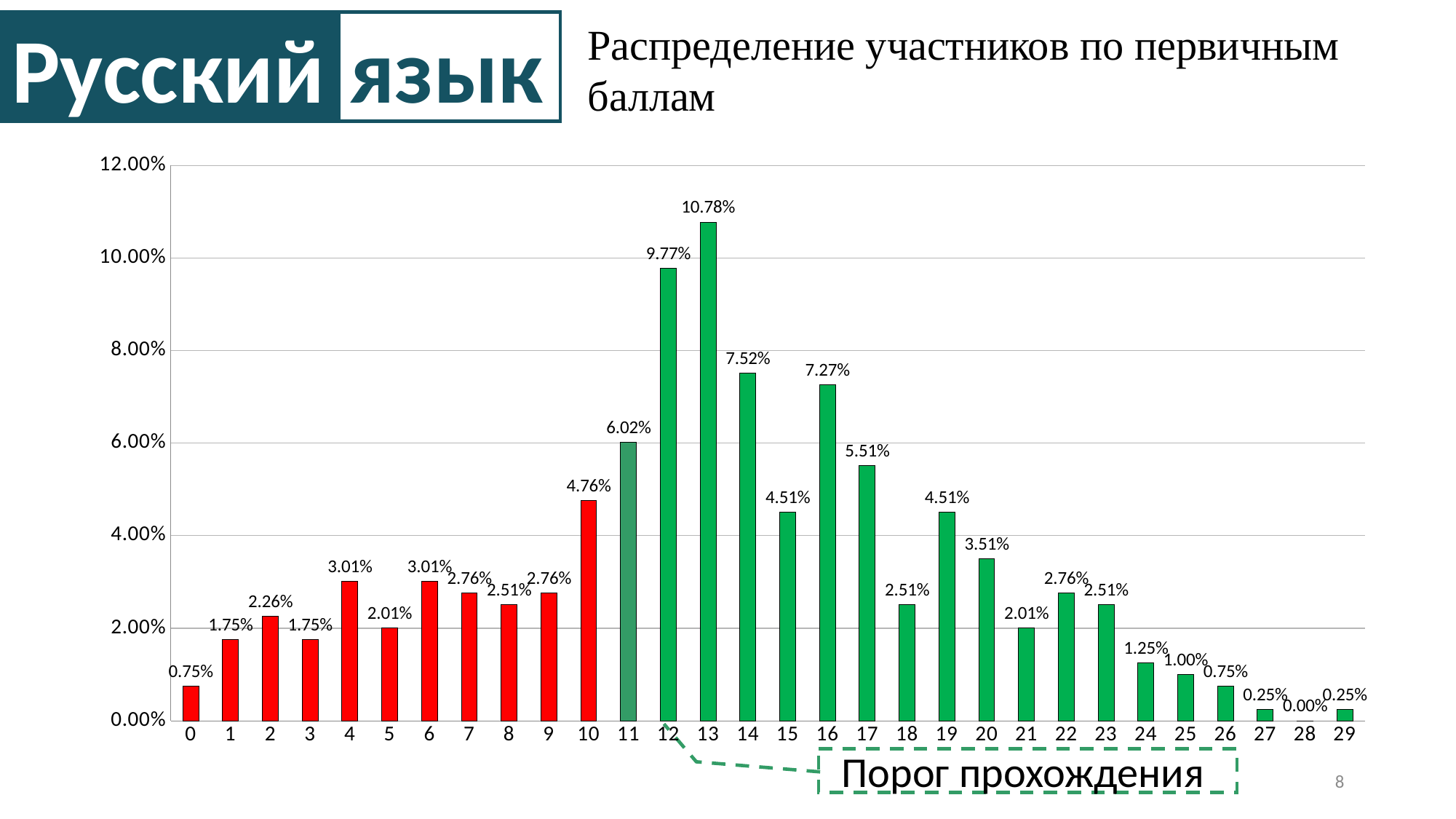
What colour are the bars for scores 0 to 10? red Do the values rise or fall from score 13 to score 18? fall Which score has the lowest share of participants? 28 What kind of chart is shown on the slide? bar chart What is the value for score 13? 10.78% How many score categories are shown on the x axis? 30 Which score has the highest share of participants? 13 What is the value for score 20? 3.51% What is the value for score 10? 4.76% Is the value for score 12 greater or less than 8.00%? greater Which is larger, the value for score 14 or the value for score 16? 14 What is the difference between the values for score 13 and score 12? 1.01%